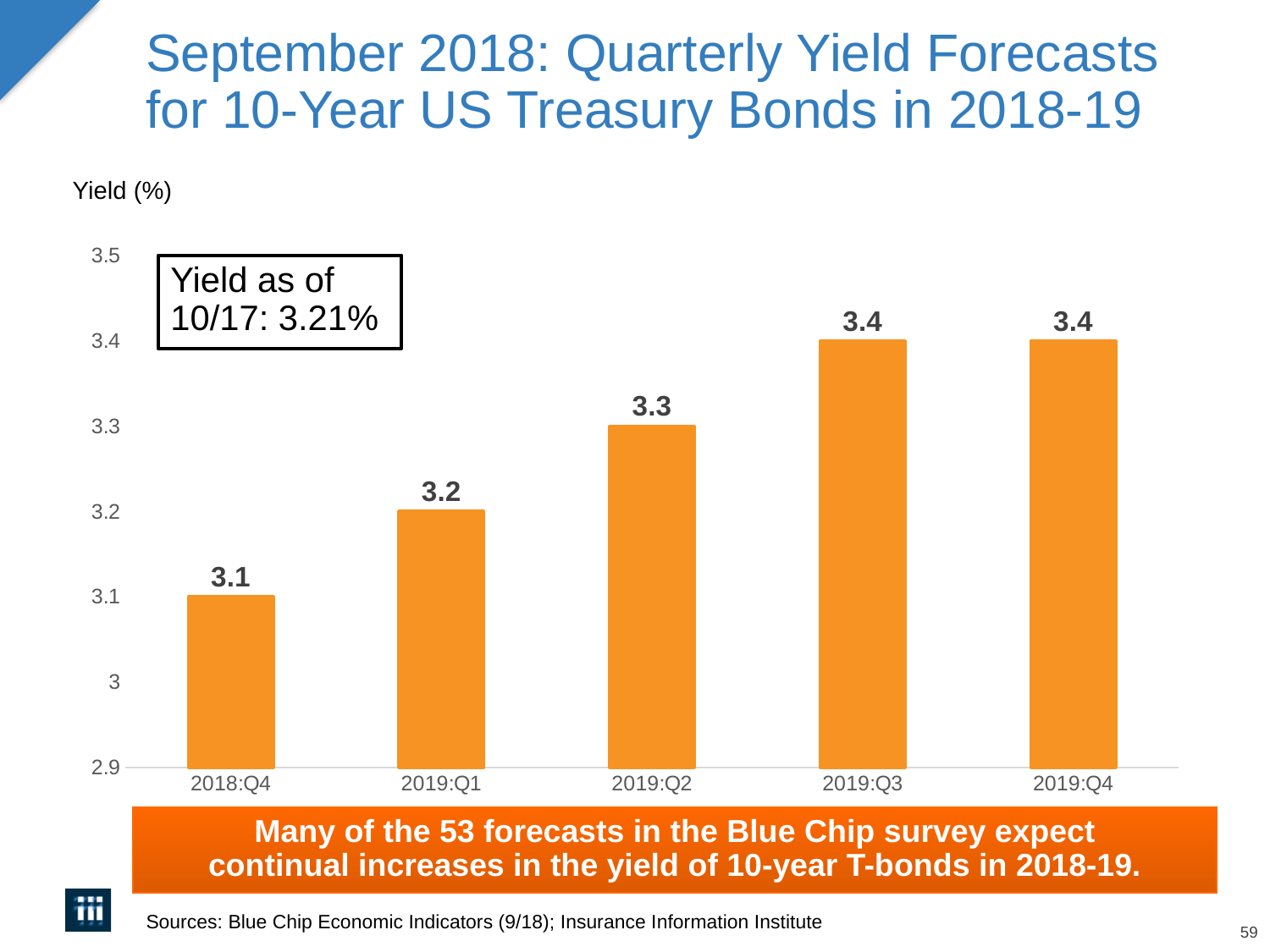
Is the forecast yield for 2019:Q1 greater or less than 3.3? less What is the forecast yield for 2019:Q4? 3.4 What kind of chart is shown on the slide? bar chart What is the difference between the forecast yield for 2019:Q3 and 2018:Q4? 0.3 How many quarters are shown on the chart? 5 Which quarter has the lowest forecast yield? 2018:Q4 What is the forecast yield for 2018:Q4? 3.1 Do the forecast yields rise or fall from 2018:Q4 to 2019:Q3? rise Which is larger, the forecast yield for 2019:Q1 or 2019:Q2? 2019:Q2 What is the label on the vertical axis of the chart? Yield (%) What yield as of 10/17 is noted in the box on the chart? 3.21% What is the forecast yield for 2019:Q2? 3.3